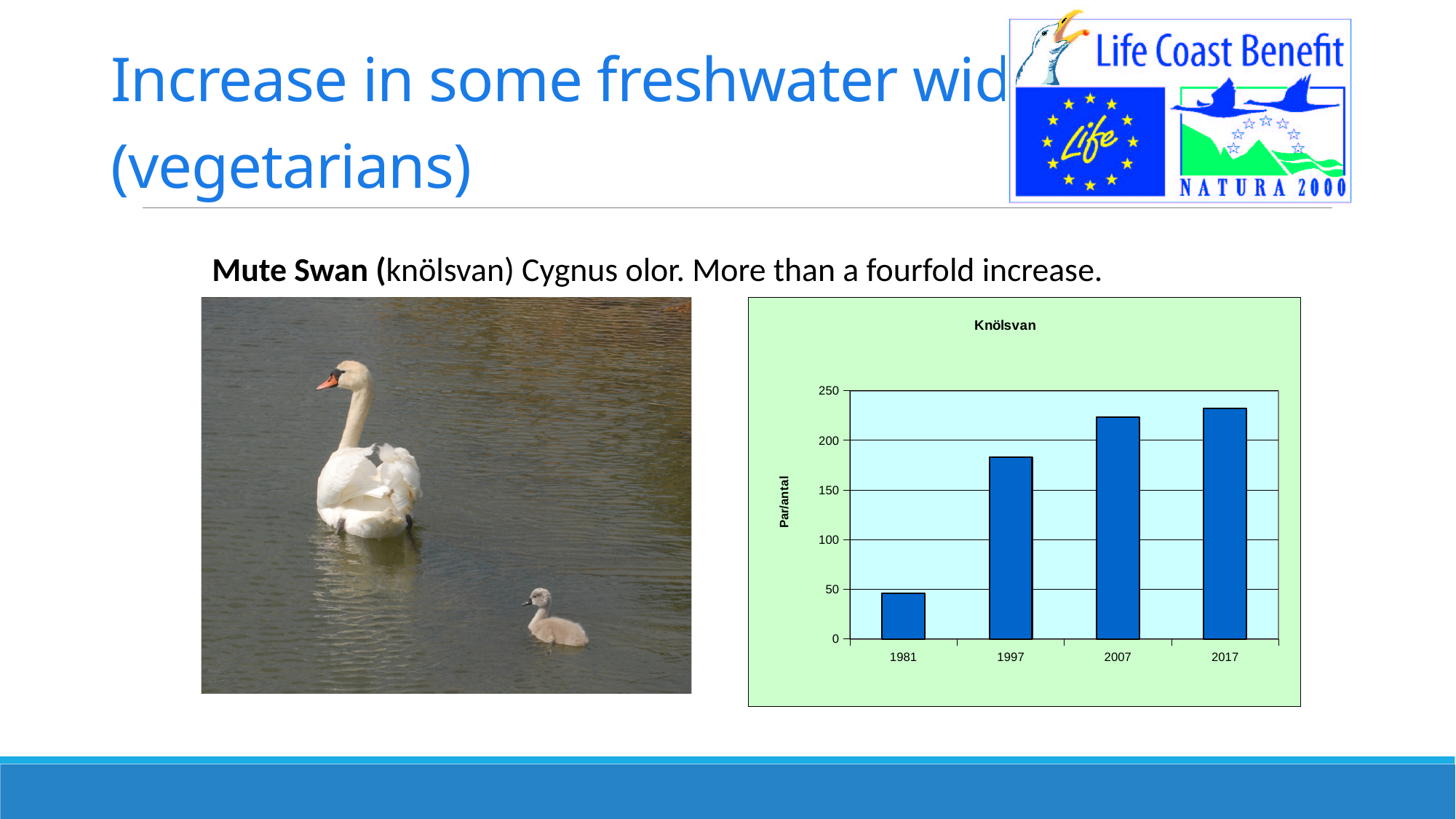
Is the value for 1981 greater or less than 100? less Which is larger, the value for 1981 or the value for 1997? 1997 Do the values rise or fall from 1981 to 2017? rise What is the title of the chart? Knölsvan What kind of chart is shown on the slide? bar chart Which year has the lowest value in the chart? 1981 Is the value for 1997 greater or less than 150? greater Which is larger, the value for 1997 or the value for 2007? 2007 Is the value for 2017 greater or less than 250? less What is the label on the vertical axis of the chart? Par/antal How many years are shown on the x axis of the chart? 4